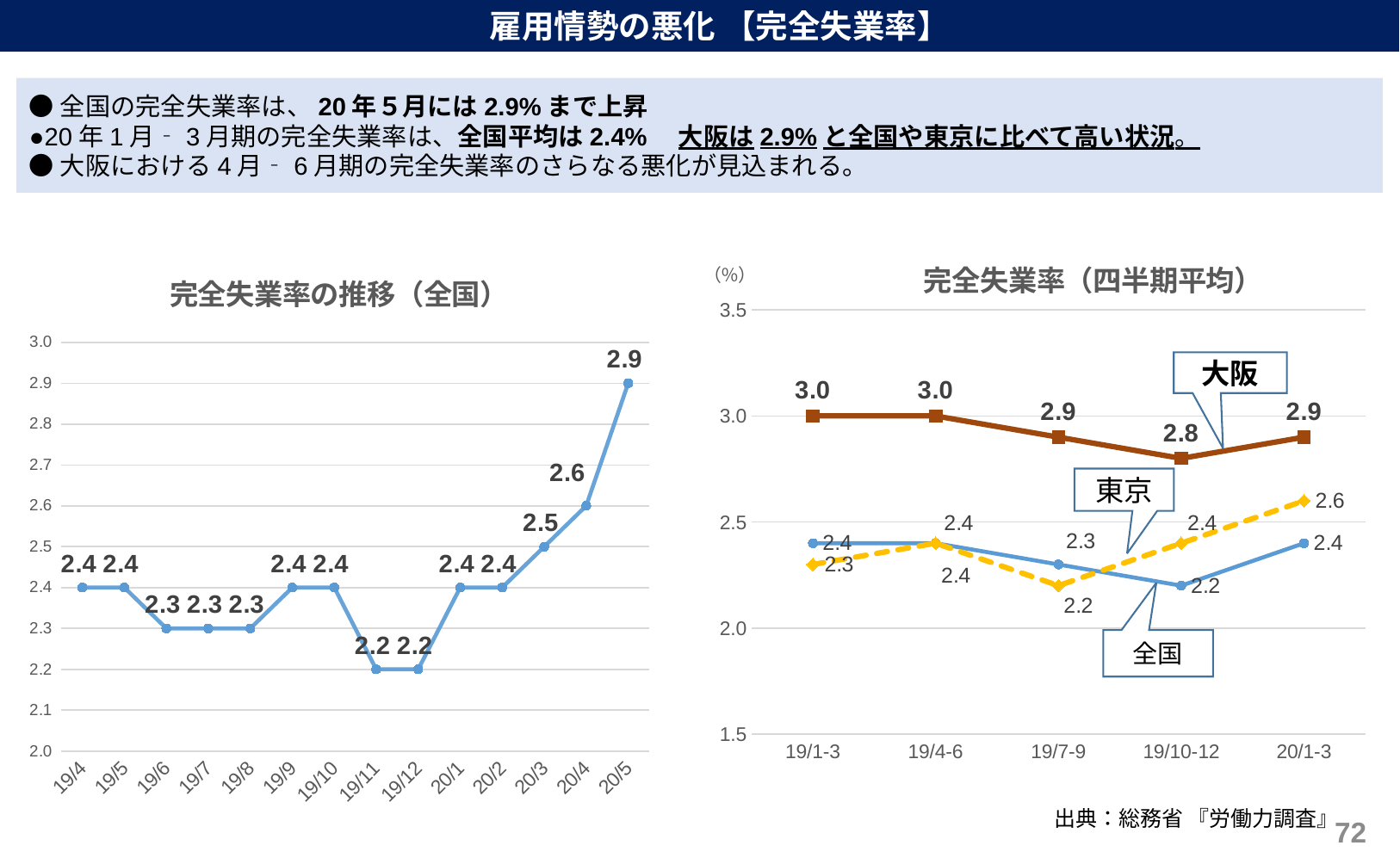
In the right chart 完全失業率（四半期平均）, what is the value for 大阪 at 19/10-12? 2.8 In the right chart 完全失業率（四半期平均）, how many series are plotted? 3 In the left chart 完全失業率の推移（全国）, how many data points are plotted? 14 In the left chart 完全失業率の推移（全国）, what is the difference between the values for 20/5 and 20/3? 0.4 What kind of chart is the right chart 完全失業率（四半期平均）? line chart In the left chart 完全失業率の推移（全国）, which month has the highest value? 20/5 In the right chart 完全失業率（四半期平均）, which series has the highest value at 20/1-3? 大阪 In the left chart 完全失業率の推移（全国）, do the values rise or fall from 20/1 to 20/5? rise In the right chart 完全失業率（四半期平均）, what is the value for 東京 at 20/1-3? 2.6 In the right chart 完全失業率（四半期平均）, what is the difference between 大阪 and 全国 at 20/1-3? 0.5 In the left chart 完全失業率の推移（全国）, what is the value for 20/5? 2.9 In the left chart 完全失業率の推移（全国）, what is the value for 19/11? 2.2